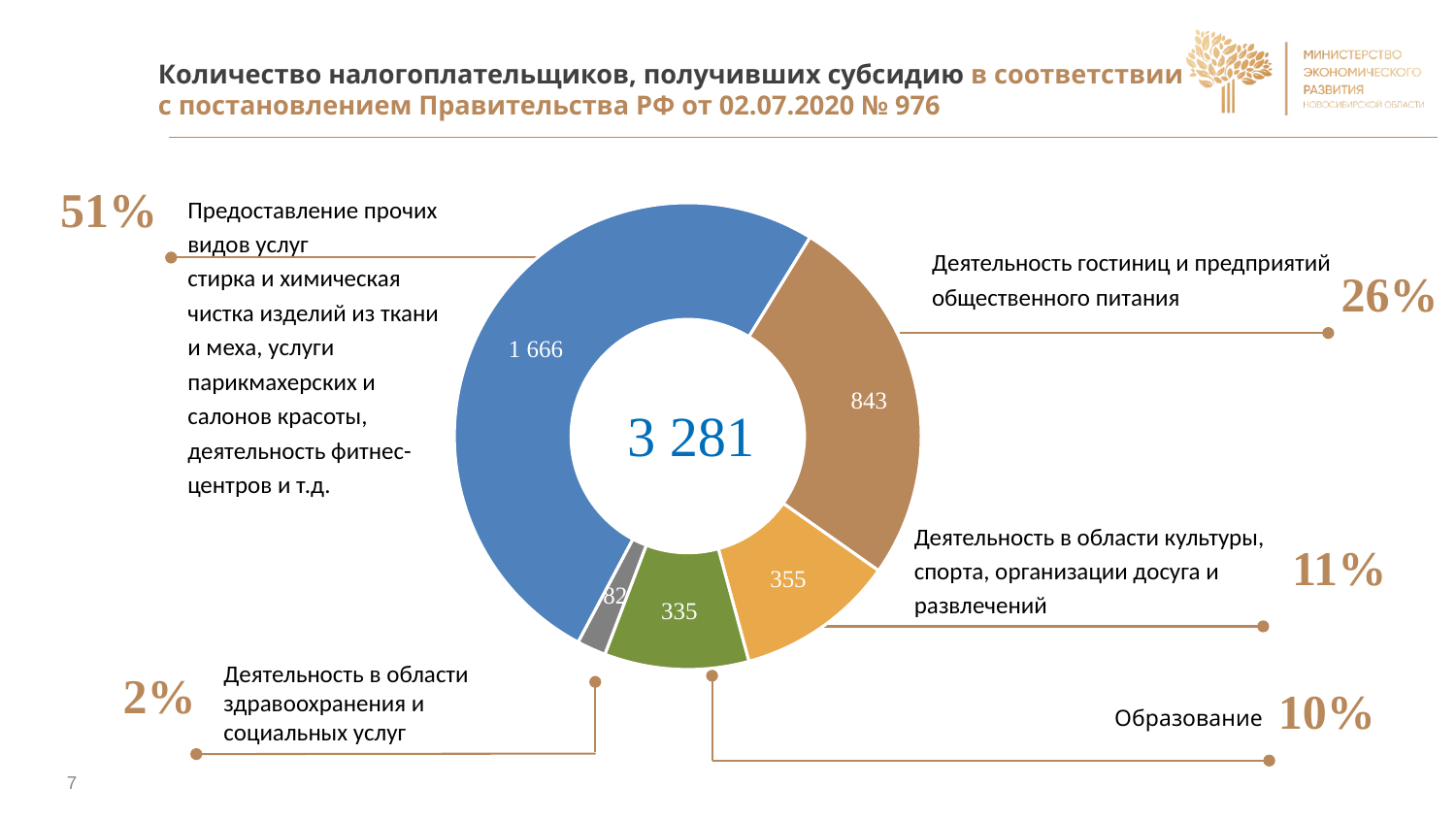
How many categories does the doughnut chart show? 5 What share of the total does «Деятельность гостиниц и предприятий общественного питания» represent? 26% Which category has the smallest value? Деятельность в области здравоохранения и социальных услуг What is the total number shown in the centre of the doughnut chart? 3 281 What is the value for «Деятельность в области здравоохранения и социальных услуг»? 82 What is the value for «Образование»? 335 What is the difference between the values for «Деятельность гостиниц и предприятий общественного питания» and «Деятельность в области культуры, спорта, организации досуга и развлечений»? 488 What type of chart is shown on the slide? Doughnut (pie) chart What is the value for «Деятельность гостиниц и предприятий общественного питания»? 843 Which is larger: the value for «Предоставление прочих видов услуг» or for «Образование»? Предоставление прочих видов услуг Which category has the largest value? Предоставление прочих видов услуг What is the value for «Деятельность в области культуры, спорта, организации досуга и развлечений»? 355